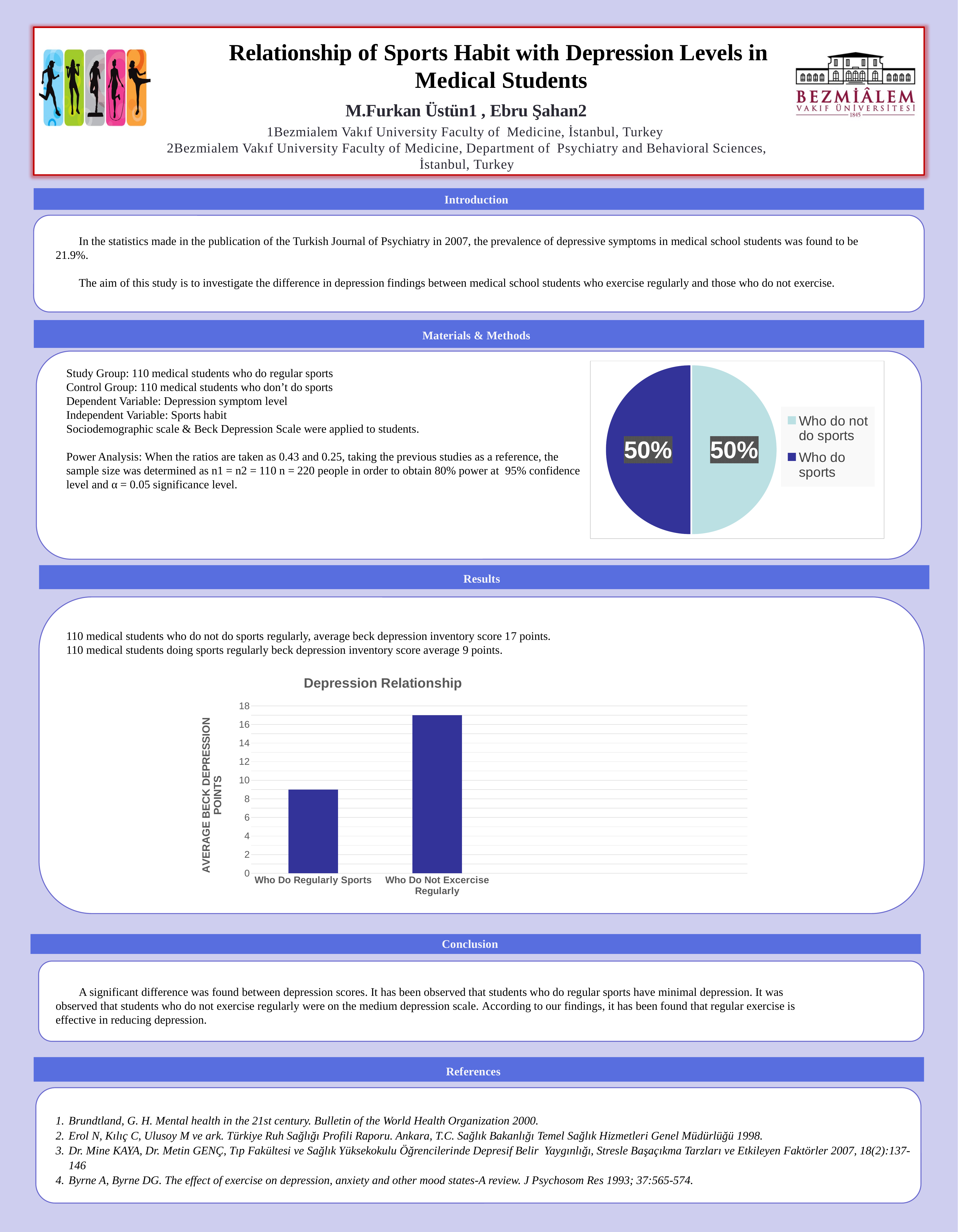
How many categories are shown in the 'Depression Relationship' chart? 2 In the 'Depression Relationship' chart, which category has the highest average Beck depression points? Who Do Not Excercise Regularly In the 'Depression Relationship' chart, which category has the lowest average Beck depression points? Who Do Regularly Sports In the pie chart in the Materials & Methods section, what share is labelled for 'Who do sports'? 50% What kind of chart is the chart in the Materials & Methods section? pie chart How many entries does the legend of the pie chart in the Materials & Methods section list? 2 In the 'Depression Relationship' chart, is the value for 'Who Do Not Excercise Regularly' greater or less than 16? greater In the pie chart in the Materials & Methods section, which colour represents 'Who do sports'? dark blue What is the y-axis title of the 'Depression Relationship' chart? AVERAGE BECK DEPRESSION POINTS What kind of chart is the 'Depression Relationship' chart? bar chart In the pie chart in the Materials & Methods section, what share is labelled for 'Who do not do sports'? 50% In the 'Depression Relationship' chart, is the value for 'Who Do Regularly Sports' greater or less than 10? less